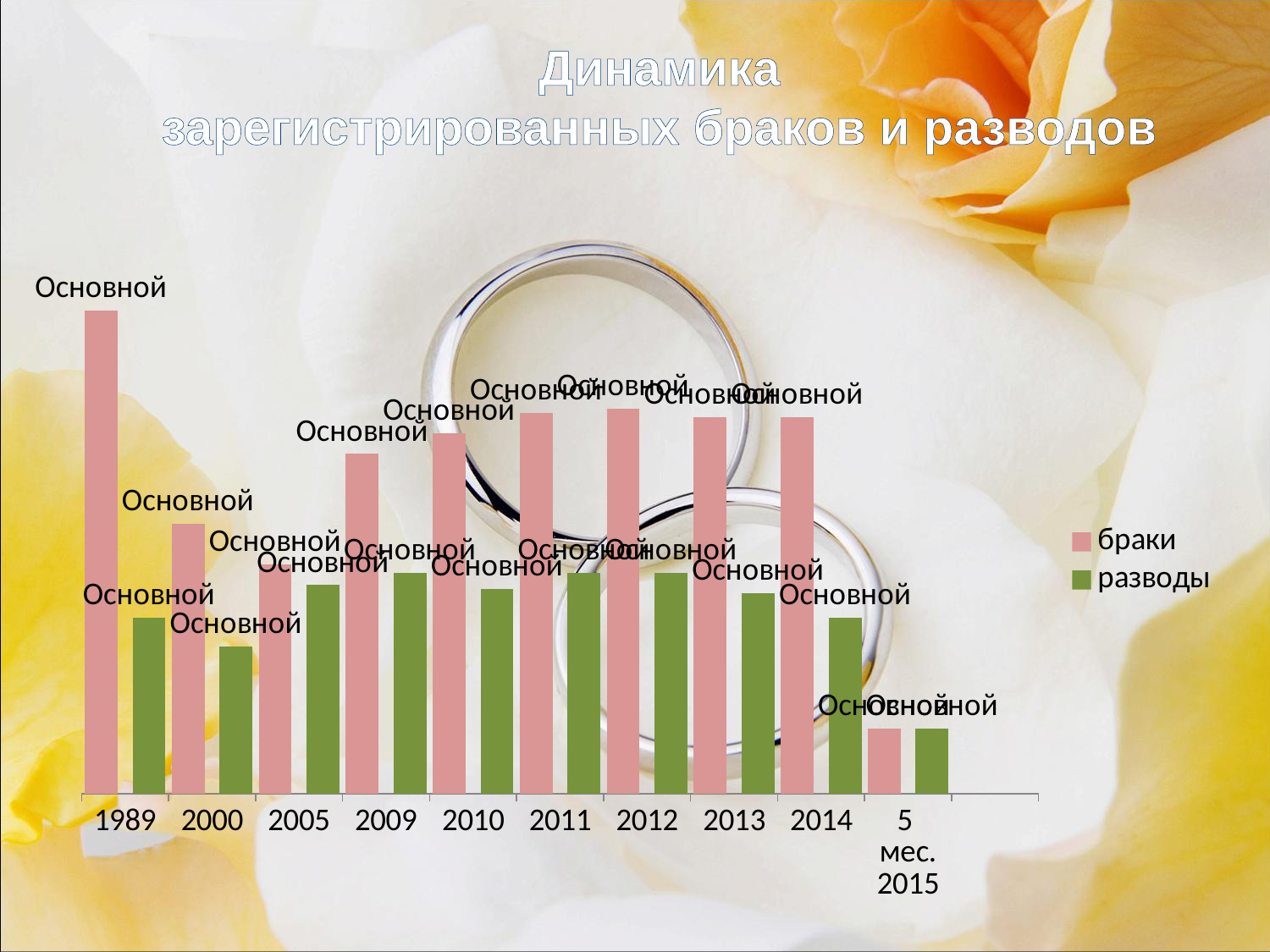
In which category is the value for разводы lowest? 5 мес. 2015 In 2014, which is larger, браки or разводы? браки How many series does the legend list? 2 How many categories are shown on the x axis? 10 In which category is the value for браки lowest? 5 мес. 2015 Do the values for браки rise or fall from 2000 to 2011? rise In which category is the value for браки highest? 1989 Which series is shown in green? разводы What kind of chart is shown on the slide? bar chart Which is larger, the value for браки in 1989 or in 2000? 1989 What is the title of the chart? Динамика зарегистрированных браков и разводов Which is larger, the value for разводы in 2000 or in 2005? 2005